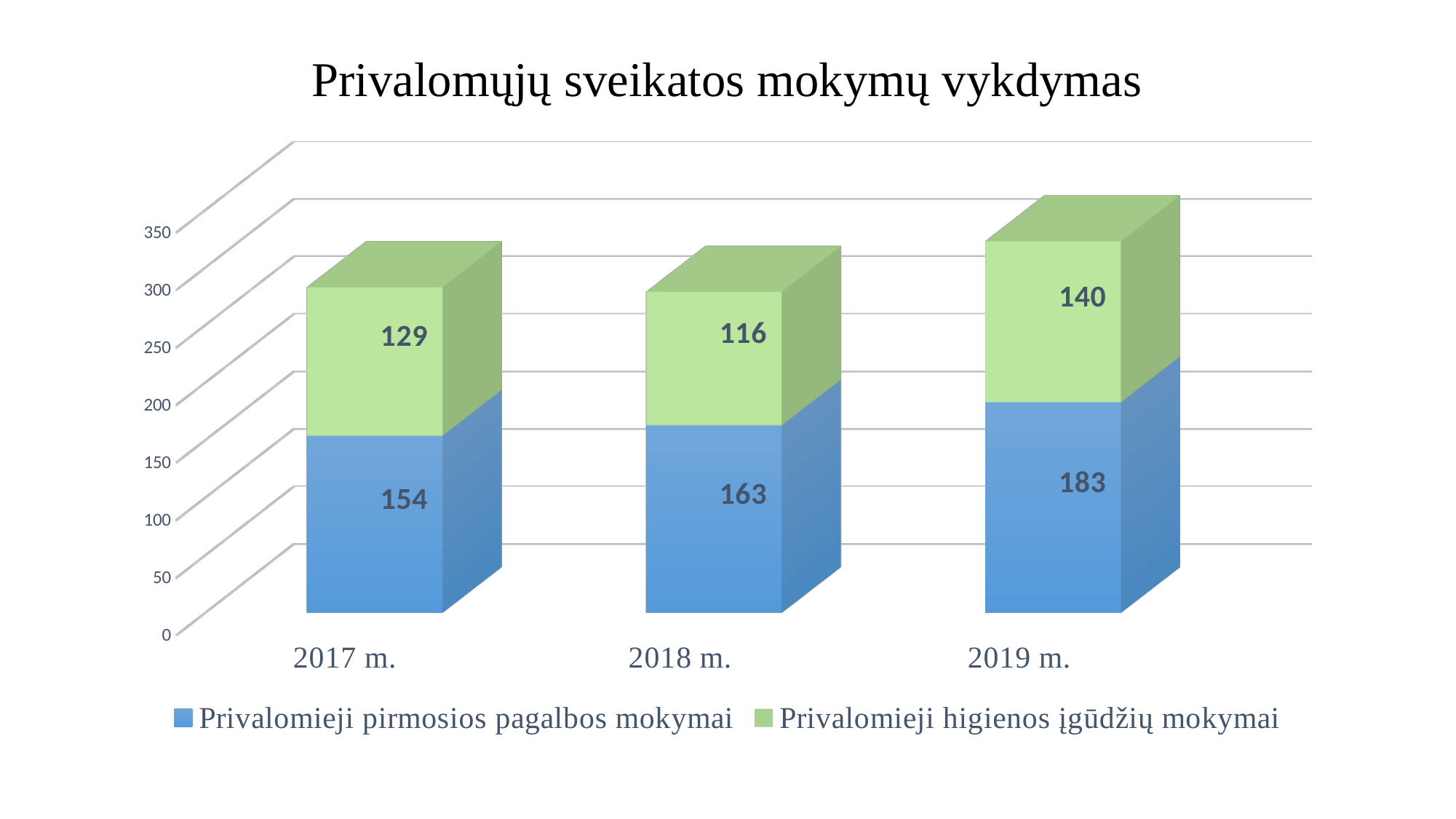
How many series does the legend list? 2 What is the total of the stacked bar for 2017 m.? 283 What is the difference between Privalomieji pirmosios pagalbos mokymai in 2019 m. and 2017 m.? 29 What is the value for Privalomieji higienos įgūdžių mokymai in 2018 m.? 116 In which year is Privalomieji higienos įgūdžių mokymai lowest? 2018 m. Which is larger in 2018 m.: Privalomieji pirmosios pagalbos mokymai or Privalomieji higienos įgūdžių mokymai? Privalomieji pirmosios pagalbos mokymai In which year is Privalomieji pirmosios pagalbos mokymai highest? 2019 m. How many years are shown on the x axis? 3 What is the value for Privalomieji pirmosios pagalbos mokymai in 2017 m.? 154 What is the total of the stacked bar for 2019 m.? 323 What is the value for Privalomieji higienos įgūdžių mokymai in 2019 m.? 140 What kind of chart is shown on the slide? Stacked bar chart